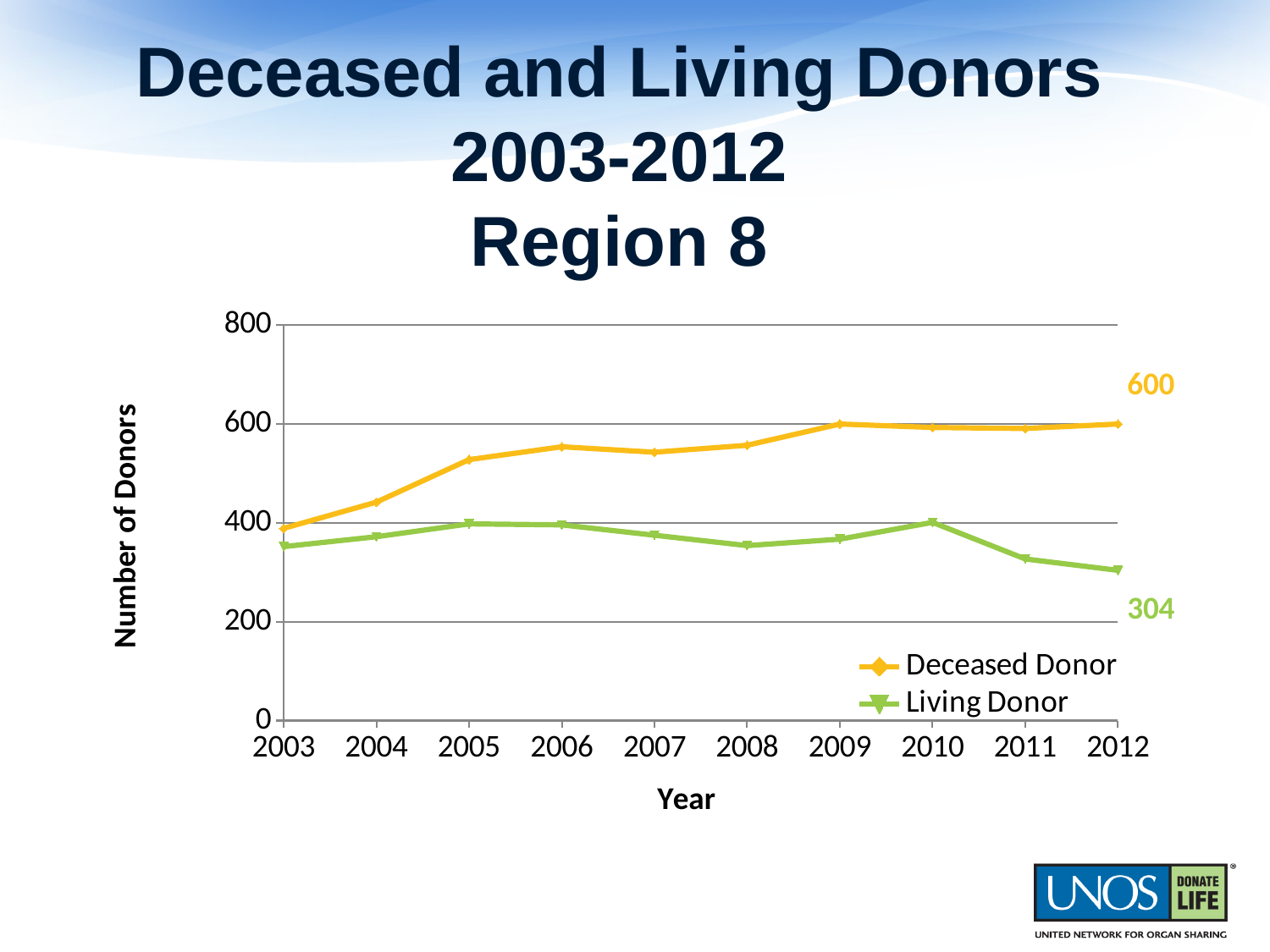
What is the difference between the Deceased Donor and Living Donor values in 2012? 296 How many years are shown on the x axis? 10 What kind of chart is shown on the slide? line chart In which year is the Deceased Donor value lowest? 2003 In which year is the Living Donor value lowest? 2012 Is the value for Living Donor in 2011 greater or less than 400? less Does the Living Donor line rise or fall from 2010 to 2012? fall Is the value for Deceased Donor in 2005 greater or less than 400? greater In 2012, which series has the larger value, Deceased Donor or Living Donor? Deceased Donor What is the value for Deceased Donor in 2012? 600 How many series does the legend list? 2 What is the value for Living Donor in 2012? 304